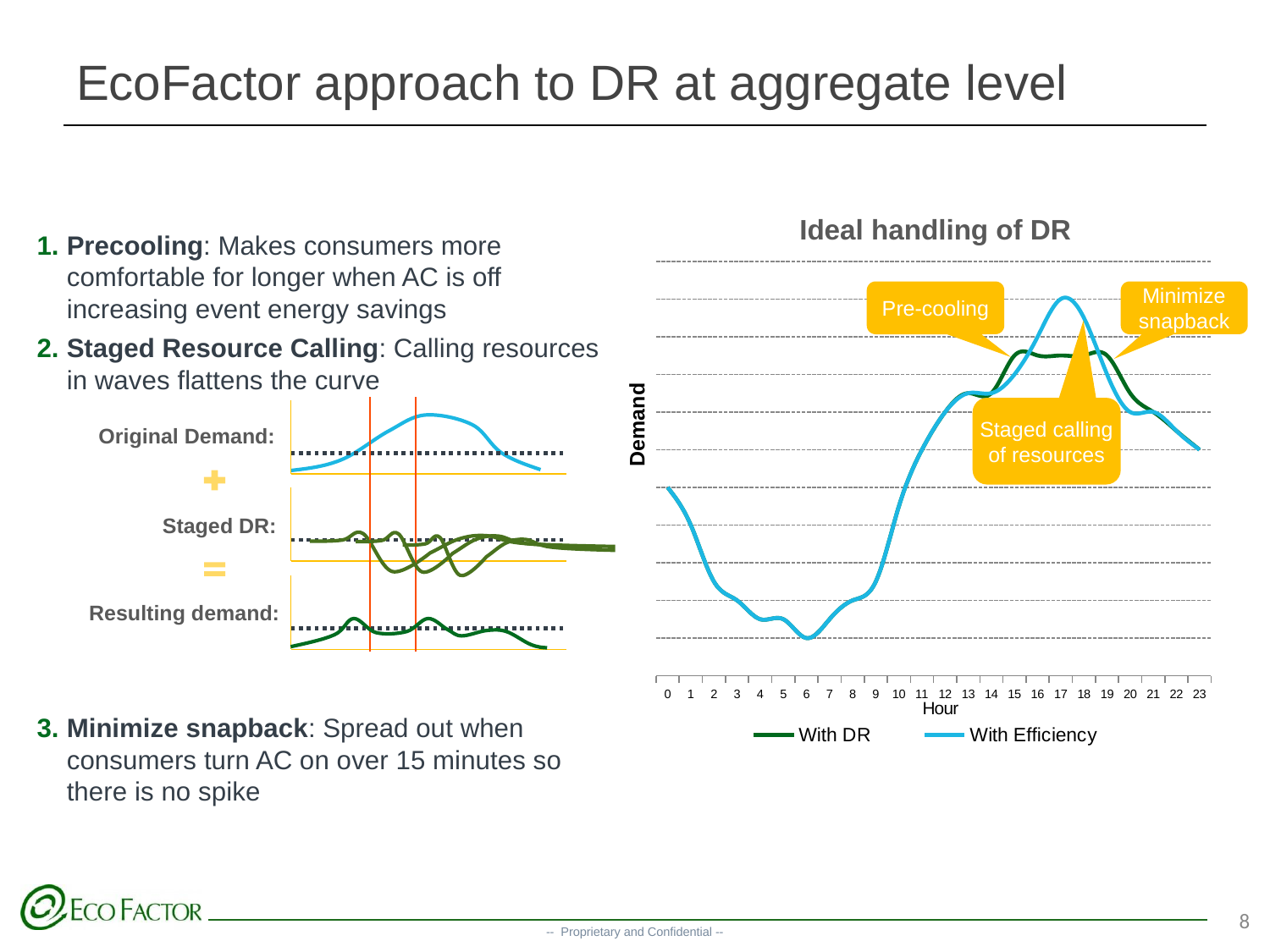
What are the two series named in the legend of the "Ideal handling of DR" chart? With DR and With Efficiency In the "Ideal handling of DR" chart, at which hour does the With Efficiency line reach its lowest point? 6 In the "Ideal handling of DR" chart, does the With Efficiency line rise or fall between hour 17 and hour 23? fall What kind of chart is the "Ideal handling of DR" chart? line chart In the "Ideal handling of DR" chart, which series is higher at hour 15, With DR or With Efficiency? With DR How many hour values are shown on the x axis of the "Ideal handling of DR" chart? 24 What is the label of the x axis on the "Ideal handling of DR" chart? Hour In the "Ideal handling of DR" chart, does the With Efficiency line rise or fall between hour 0 and hour 6? fall In the "Ideal handling of DR" chart, which series is higher at hour 17, With DR or With Efficiency? With Efficiency In the "Ideal handling of DR" chart, at which hour does the With Efficiency line reach its highest point? 17 In the "Ideal handling of DR" chart, does the With Efficiency line rise or fall between hour 6 and hour 17? rise How many series does the legend of the "Ideal handling of DR" chart list? 2